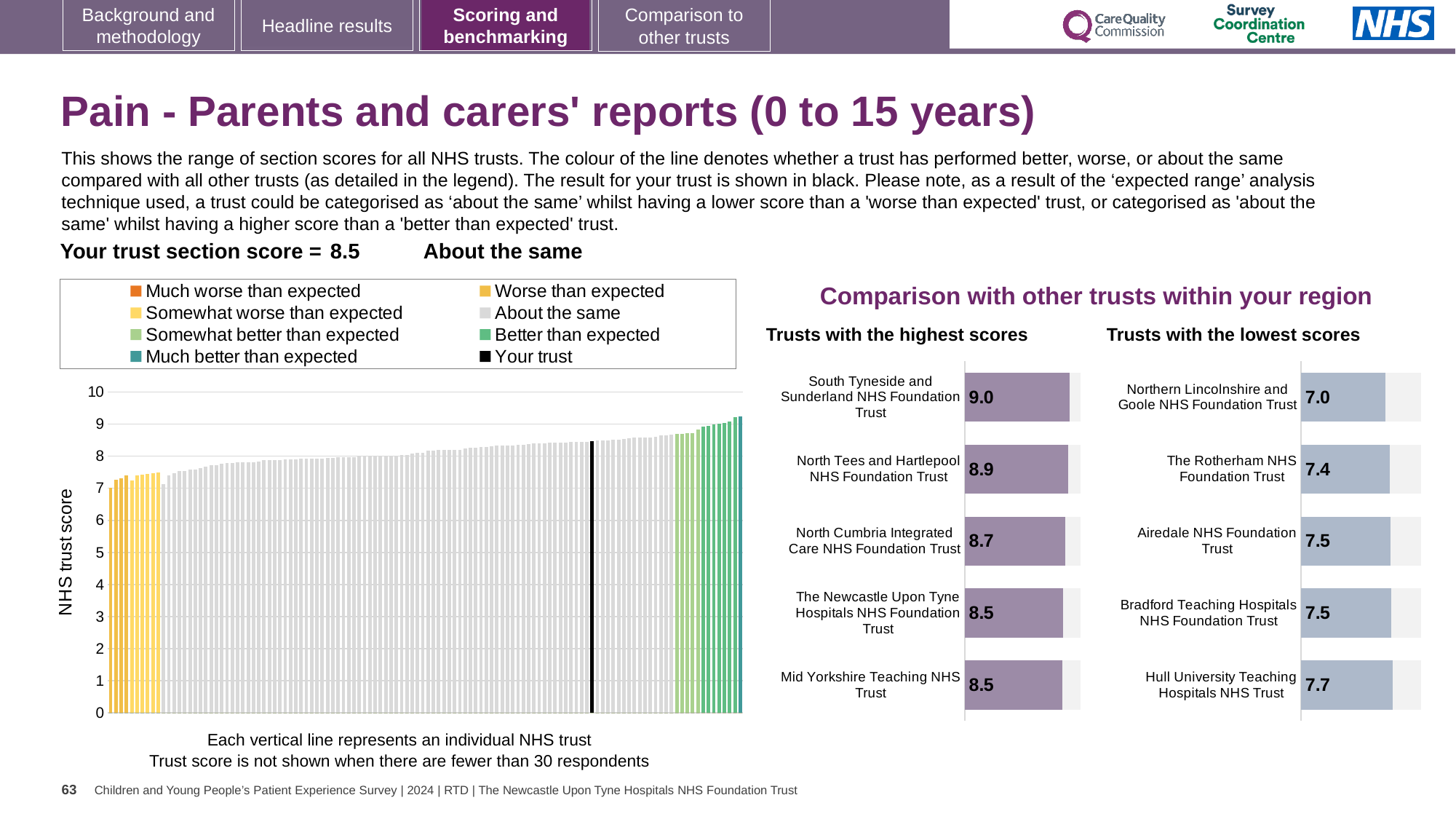
What kind of chart is the large chart on the left showing NHS trust scores? bar chart In the 'Trusts with the lowest scores' chart, which trust has the lowest score? Northern Lincolnshire and Goole NHS Foundation Trust In the 'Trusts with the highest scores' chart, how many trusts are shown? 5 In the 'Trusts with the highest scores' chart, which trust has the highest score? South Tyneside and Sunderland NHS Foundation Trust How many entries does the legend above the large chart on the left list? 8 In the 'Trusts with the highest scores' chart, what is the score for South Tyneside and Sunderland NHS Foundation Trust? 9.0 In the 'Trusts with the lowest scores' chart, what is the difference between the scores of Hull University Teaching Hospitals NHS Trust and Northern Lincolnshire and Goole NHS Foundation Trust? 0.7 In the large chart on the left, is the value for the black bar (Your trust) greater or less than 8? greater In the 'Trusts with the highest scores' chart, what is the difference between the scores of South Tyneside and Sunderland NHS Foundation Trust and North Cumbria Integrated Care NHS Foundation Trust? 0.3 In the 'Trusts with the lowest scores' chart, which has the larger score: The Rotherham NHS Foundation Trust or Hull University Teaching Hospitals NHS Trust? Hull University Teaching Hospitals NHS Trust In the 'Trusts with the lowest scores' chart, what is the score for The Rotherham NHS Foundation Trust? 7.4 In the large chart on the left, what is the label on the vertical axis? NHS trust score